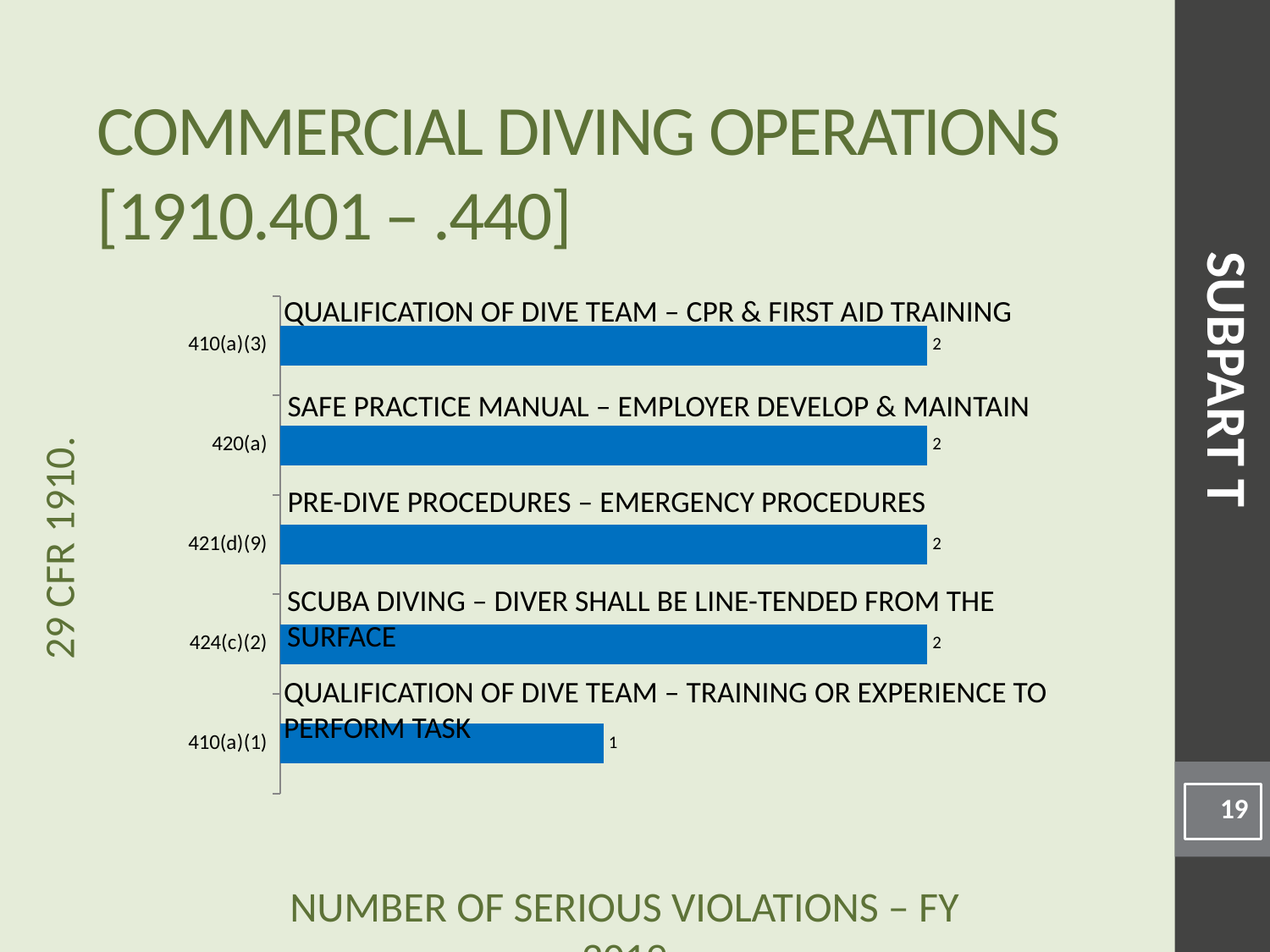
What is the value shown for 424(c)(2)? 2 What is the difference between the values for 420(a) and 410(a)(1)? 1 What is the number of serious violations for 410(a)(1)? 1 How many categories are plotted in the chart? 5 How many categories have a value of 2? 4 What is the value shown for 421(d)(9)? 2 What is the total of all the values plotted in the chart? 9 What kind of chart is shown on the slide? Bar chart Which is larger, the value for 420(a) or the value for 410(a)(1)? 420(a) What colour are the bars in the chart? Blue Which category has the lowest number of serious violations? 410(a)(1) What is the number of serious violations for 410(a)(3)? 2